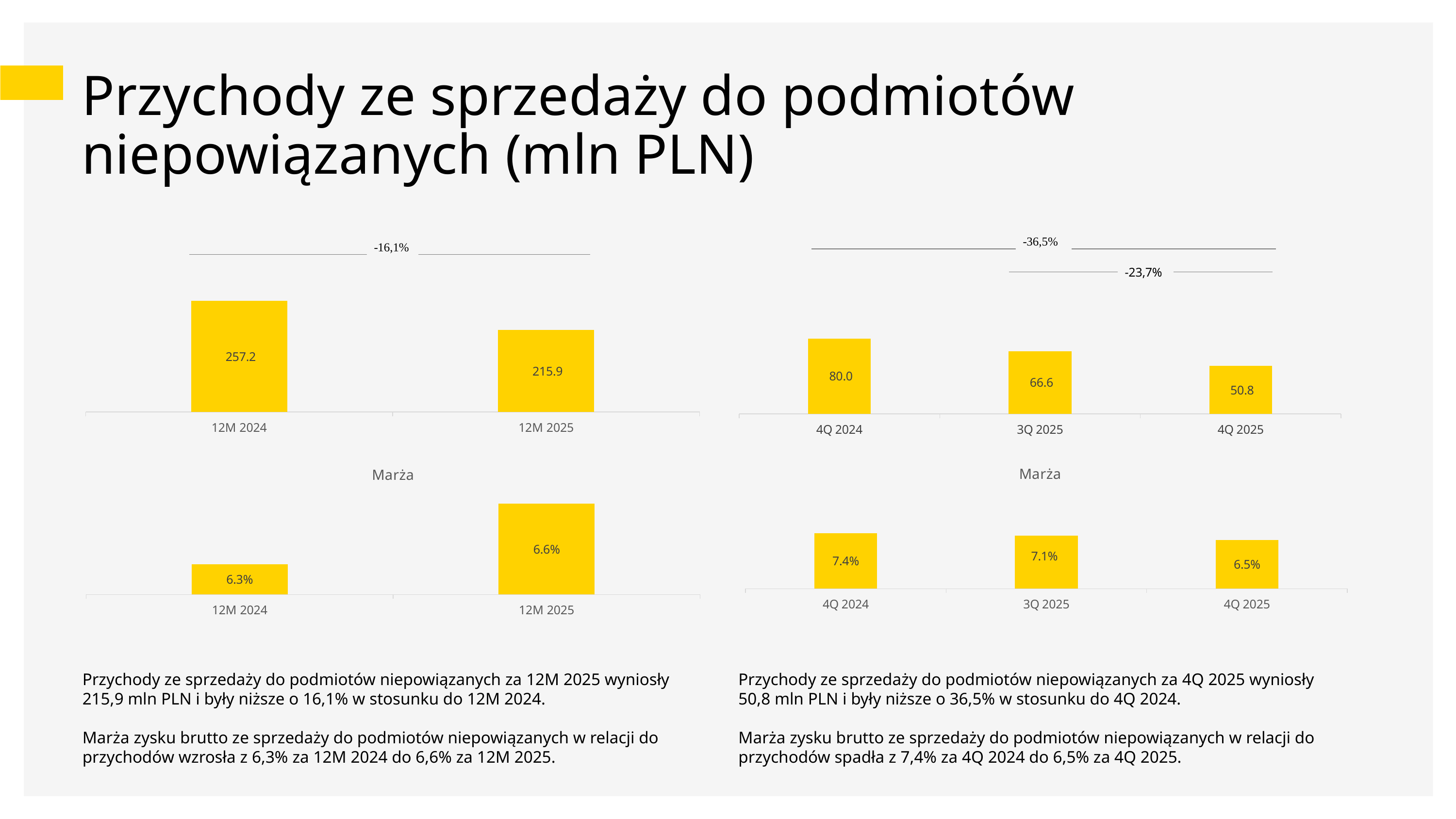
In the top-left chart (12M revenue), what percentage change is shown between 12M 2024 and 12M 2025? -16,1% In the bottom-left chart (12M Marża), what is the value for 12M 2025? 6.6% What type of chart is the bottom-right chart (quarterly Marża)? Bar chart In the top-right chart (quarterly revenue), what is the value for 3Q 2025? 66.6 In the top-right chart (quarterly revenue), which quarter has the highest value? 4Q 2024 In the bottom-left chart (12M Marża), which category has the lower value? 12M 2024 In the top-right chart (quarterly revenue), how many quarters are plotted? 3 In the top-right chart (quarterly revenue), what is the difference between the 4Q 2024 and 4Q 2025 values? 29.2 In the bottom-right chart (quarterly Marża), what is the value for 4Q 2025? 6.5% In the top-left chart (12M revenue), what is the value for 12M 2025? 215.9 In the top-left chart (12M revenue), what is the difference between the 12M 2024 and 12M 2025 values? 41.3 In the top-left chart (12M revenue), what is the value for 12M 2024? 257.2